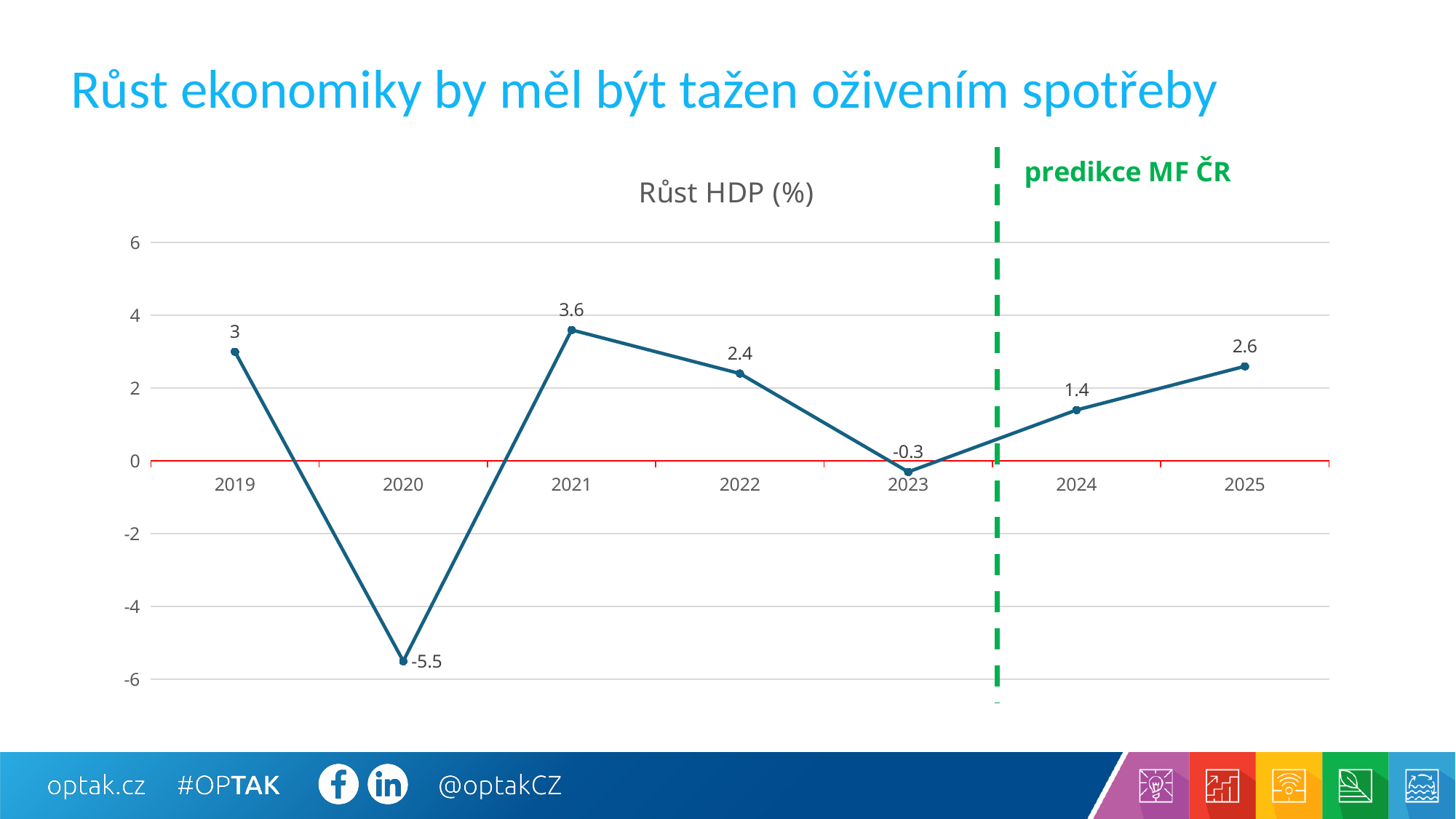
What is the GDP growth value for 2024? 1.4 What is the difference between the GDP growth values for 2021 and 2022? 1.2 How many years are plotted on the chart? 7 What kind of chart is shown on the slide? line chart Do the values rise or fall from 2023 to 2025? rise What is the GDP growth value for 2021? 3.6 Which year has a larger GDP growth value, 2019 or 2025? 2019 Which year has the highest GDP growth value? 2021 Which year has the lowest GDP growth value? 2020 What is the title of the chart? Růst HDP (%) Is the value for 2020 greater or less than -4? less What is the GDP growth value for 2020? -5.5